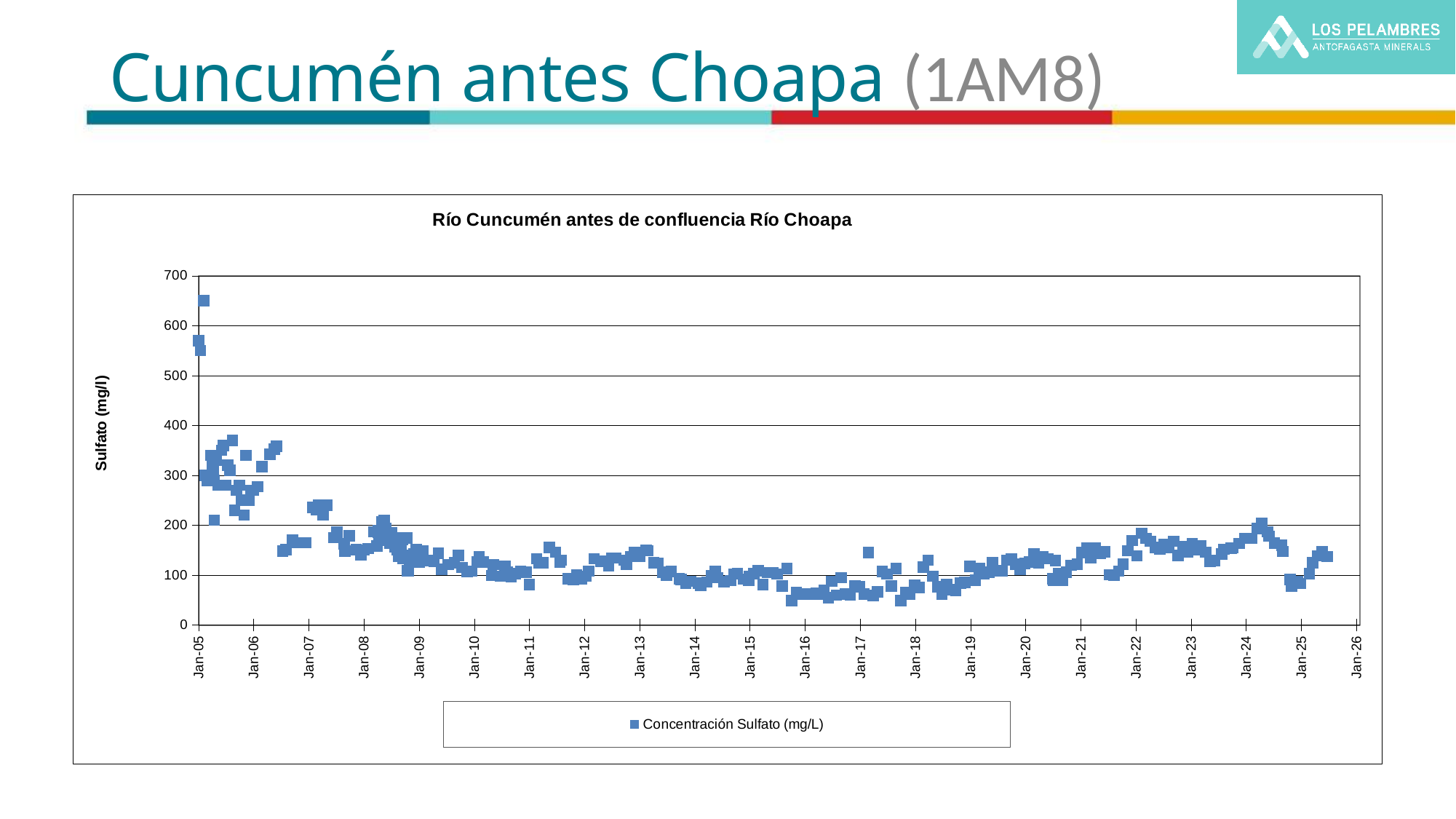
Do the sulfate values overall rise or fall from Jan-05 to Jan-25? fall What is the first label on the x axis? Jan-05 What is the highest value shown on the y axis? 700 Are the sulfate values around Jan-24 greater or less than 300? less Is the highest plotted sulfate value greater or less than 600? greater Are the sulfate values in 2005 higher or lower than those in 2016? higher What kind of chart is shown on the slide? scatter chart What is the title of the chart? Río Cuncumén antes de confluencia Río Choapa How many series does the legend list? 1 What is the last label on the x axis? Jan-26 What series does the legend list? Concentración Sulfato (mg/L) Are the sulfate values around Jan-16 greater or less than 100? less